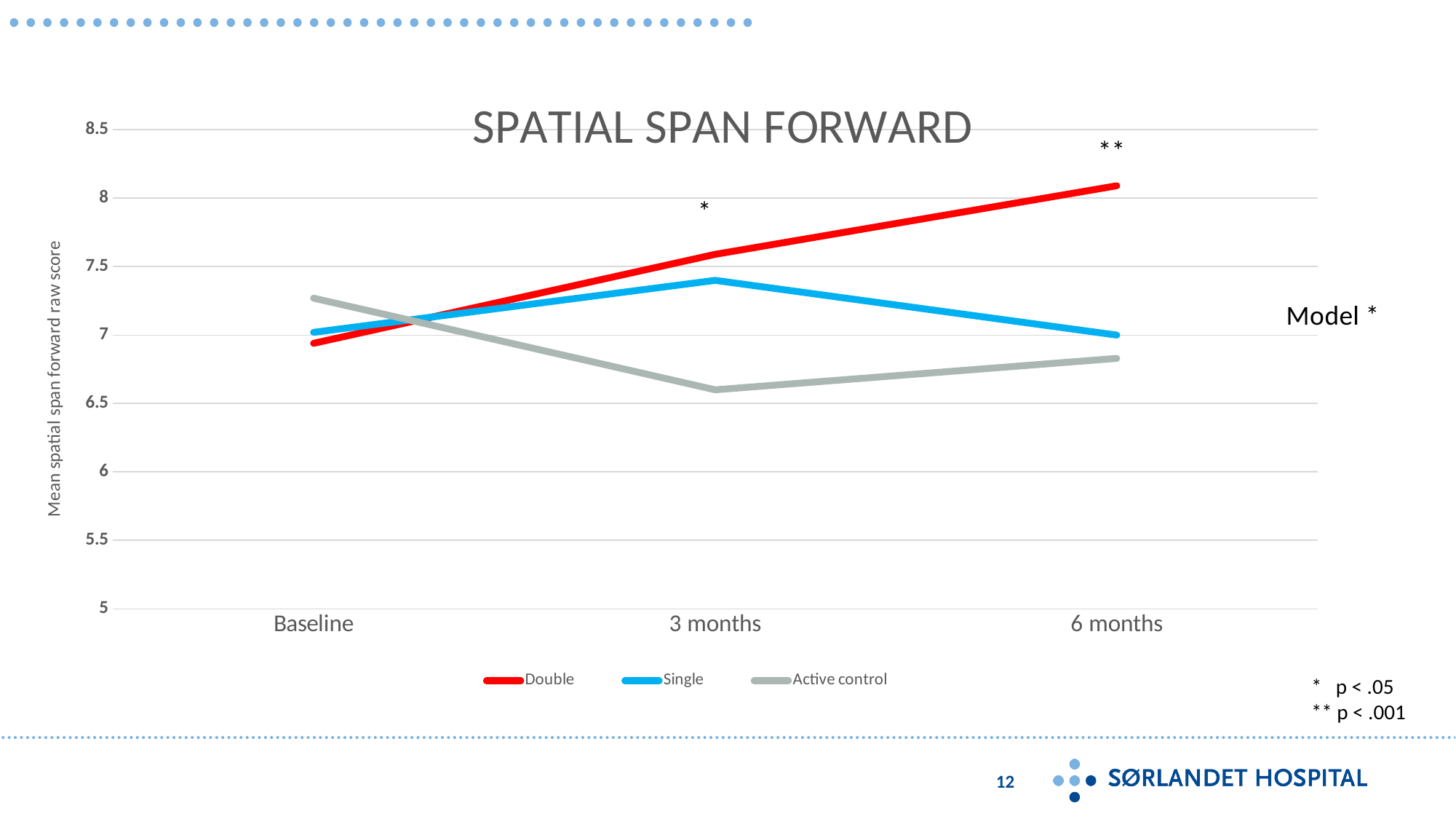
Is the value for Double at 6 months greater or less than 7.5? greater What is the title of the chart? SPATIAL SPAN FORWARD What colour is the line for the Double series? red How many time points are shown on the x axis? 3 Which series has the highest value at 6 months? Double Which series has the lowest value at 3 months? Active control At Baseline, which is larger: the value for Active control or the value for Double? Active control How many series does the legend list? 3 Is the value for Active control at 3 months greater or less than 7? less At 6 months, which is larger: the value for Double or the value for Single? Double Does the Double series rise or fall from Baseline to 6 months? rise What kind of chart is shown on the slide? line chart